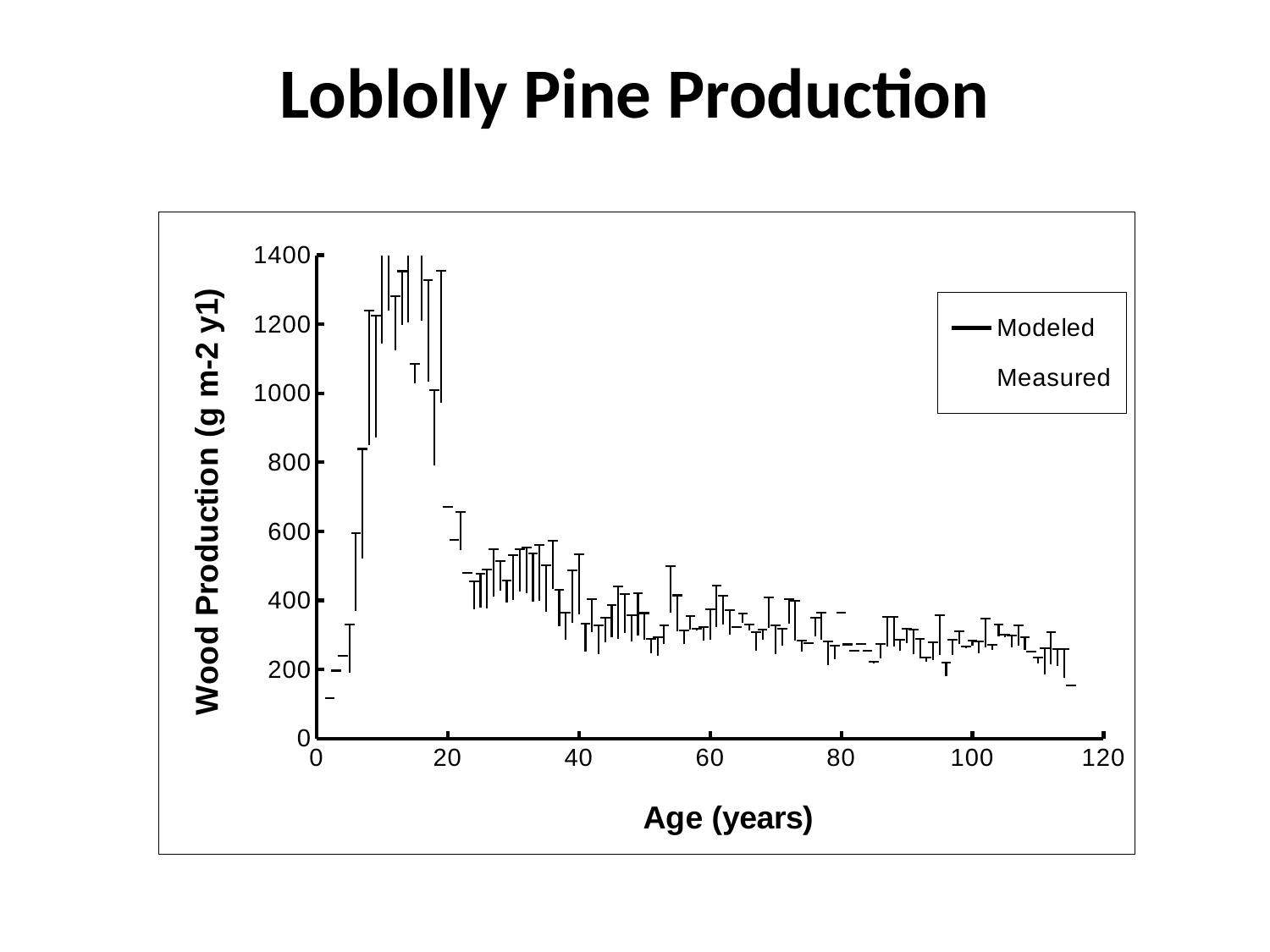
In which range of the x axis do the highest wood production values occur: 0-20, 40-60, or 100-120 years? 0-20 Is the peak wood production value, reached between ages 10 and 20, greater or less than 1000? greater How many series does the chart legend list? 2 What is the title of the slide containing the chart? Loblolly Pine Production What is the label of the y axis? Wood Production (g m-2 y1) What are the two series named in the chart legend? Modeled and Measured Is the wood production value at age 100 greater or less than 600? less Between age 20 and age 115, do the wood production values generally rise or fall as age increases? fall Is the wood production value at age 2 greater or less than 200? less